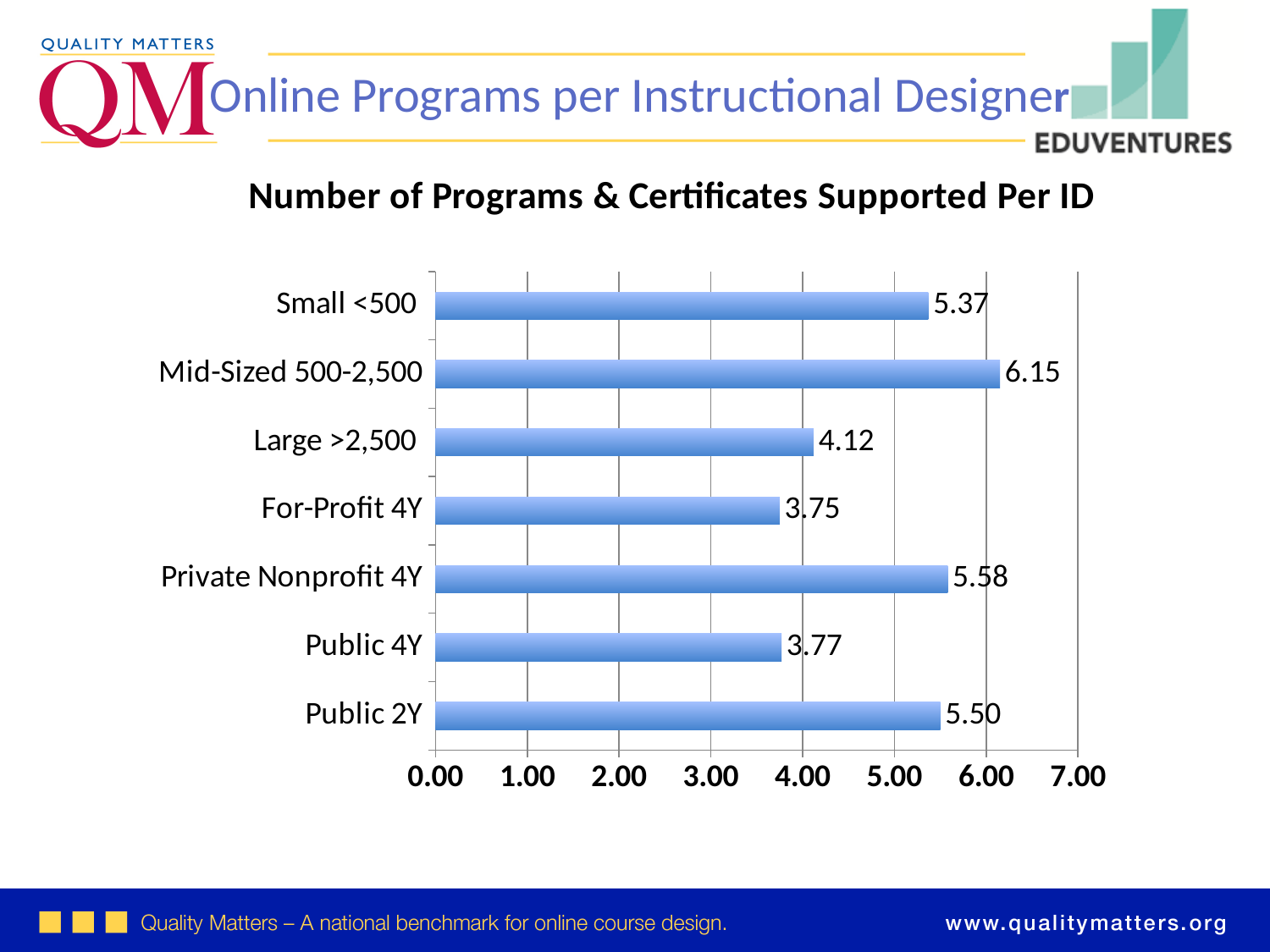
What is the title of the chart? Number of Programs & Certificates Supported Per ID Is the value for Public 4Y greater or less than 4.00? less How many categories are shown in the chart? 7 What is the number of programs & certificates supported per ID for Public 2Y? 5.50 What is the difference between the values for Mid-Sized 500-2,500 and Large >2,500? 2.03 Which category has the highest number of programs & certificates supported per ID? Mid-Sized 500-2,500 What kind of chart is shown on the slide? Bar chart Which category has the lowest number of programs & certificates supported per ID? For-Profit 4Y What is the difference between the values for Private Nonprofit 4Y and Public 4Y? 1.81 What is the value for For-Profit 4Y? 3.75 Which is larger, the value for Small <500 or the value for Large >2,500? Small <500 What is the value for Mid-Sized 500-2,500? 6.15